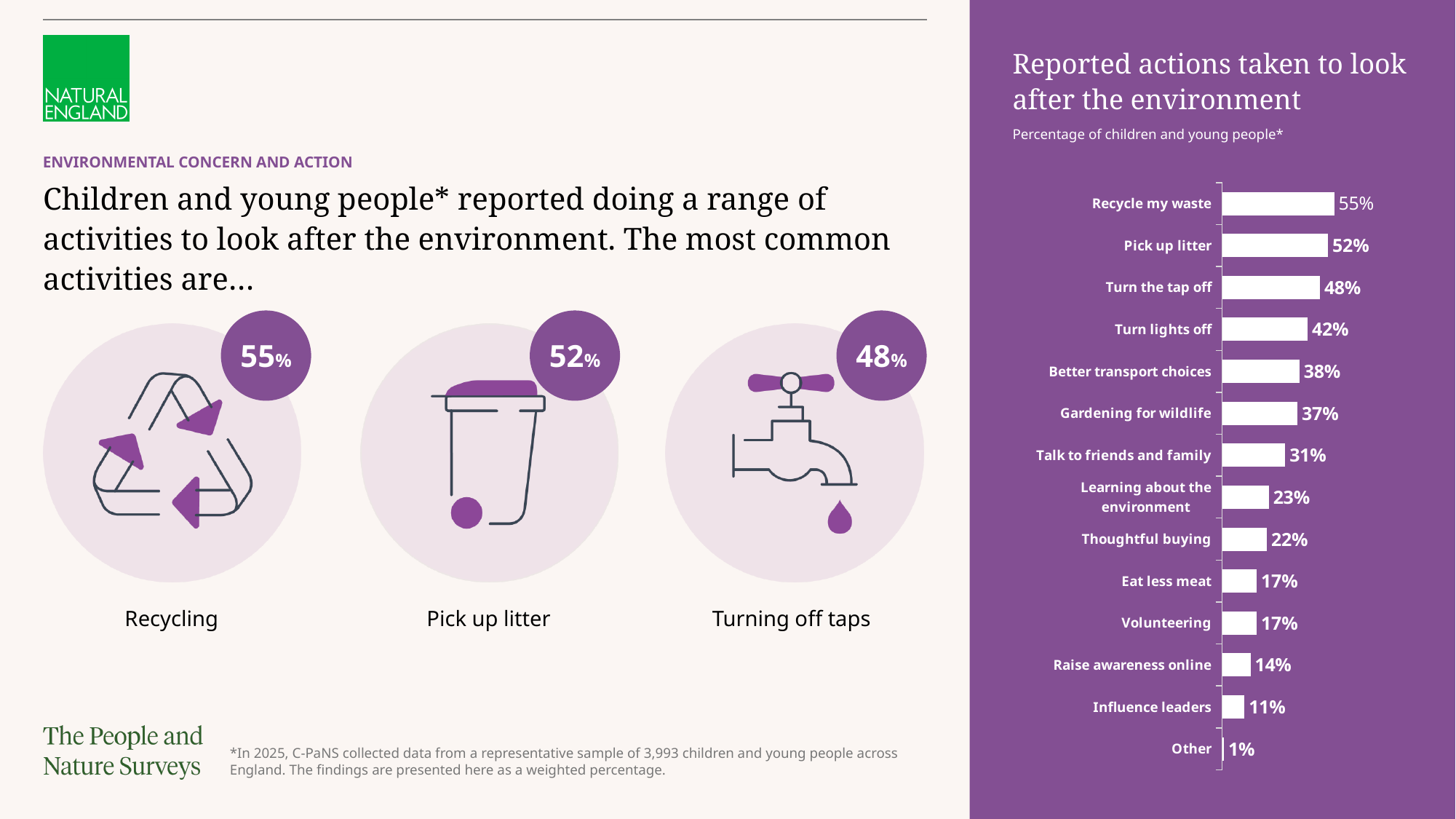
Which action has the highest percentage? Recycle my waste Which two categories both have a value of 17%? Eat less meat and Volunteering What is the difference between 'Turn the tap off' and 'Turn lights off'? 6% What is the difference between 'Pick up litter' and 'Raise awareness online'? 38% What is the value for 'Influence leaders'? 11% Which is larger, 'Better transport choices' or 'Talk to friends and family'? Better transport choices How many categories are shown in the bar chart? 14 What is the value for 'Gardening for wildlife'? 37% What percentage of children and young people reported 'Recycle my waste'? 55% What is the title of the chart? Reported actions taken to look after the environment What type of chart is shown on the slide? Bar chart Which category has the lowest percentage? Other